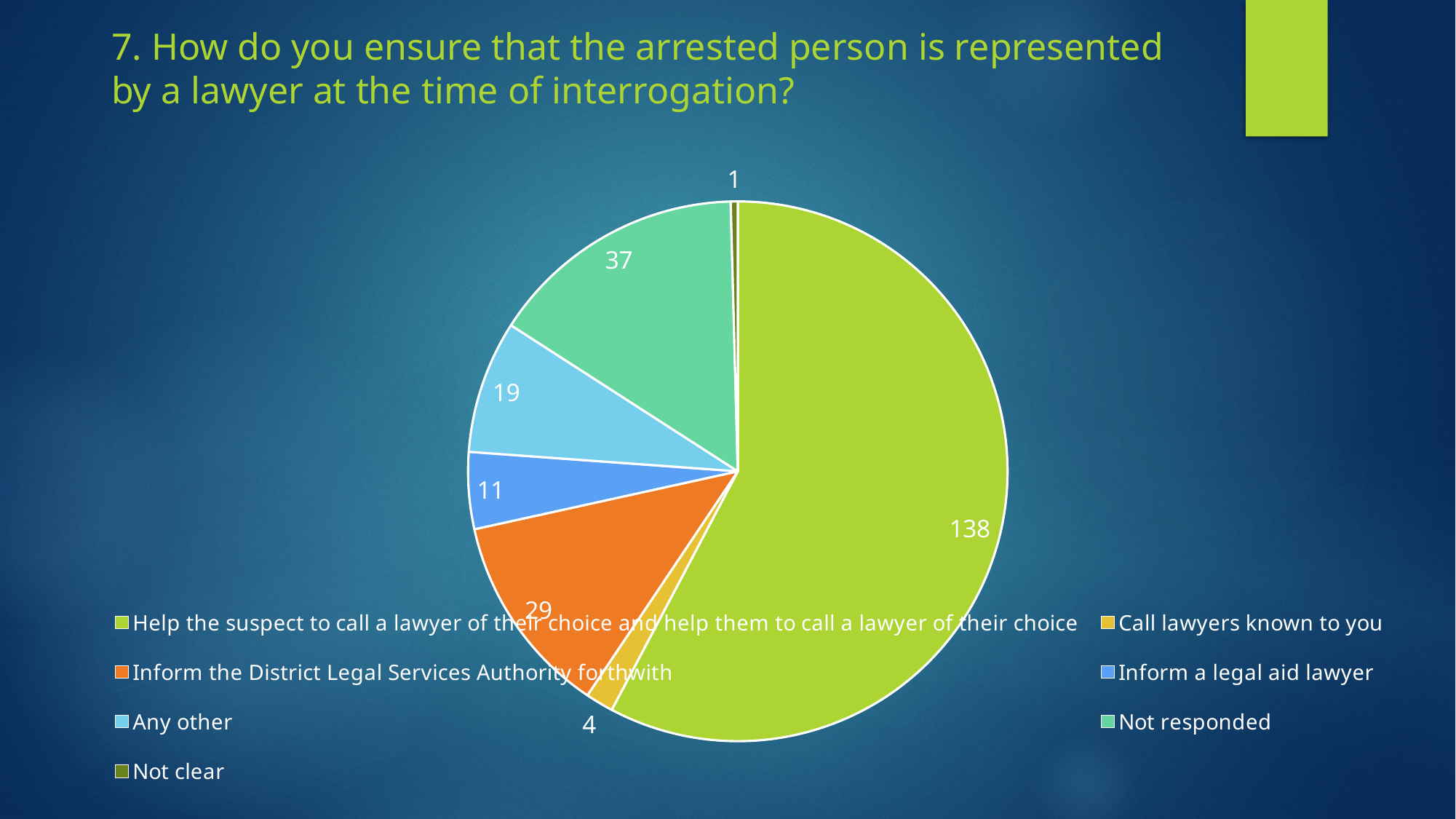
What is the value for 'Call lawyers known to you'? 4 Which category has the smallest slice in the pie chart? Not clear Which is larger, the value for 'Inform the District Legal Services Authority forthwith' or the value for 'Any other'? Inform the District Legal Services Authority forthwith What is the difference between the values for 'Not responded' and 'Any other'? 18 Which category has the largest slice in the pie chart? Help the suspect to call a lawyer of their choice and help them to call a lawyer of their choice What is the value for 'Help the suspect to call a lawyer of their choice and help them to call a lawyer of their choice'? 138 What is the value for 'Inform a legal aid lawyer'? 11 What is the value for 'Not responded'? 37 What is the value for 'Inform the District Legal Services Authority forthwith'? 29 What type of chart is shown on the slide? Pie chart How many slices does the pie chart have? 7 What is the total of all the values shown in the pie chart? 239